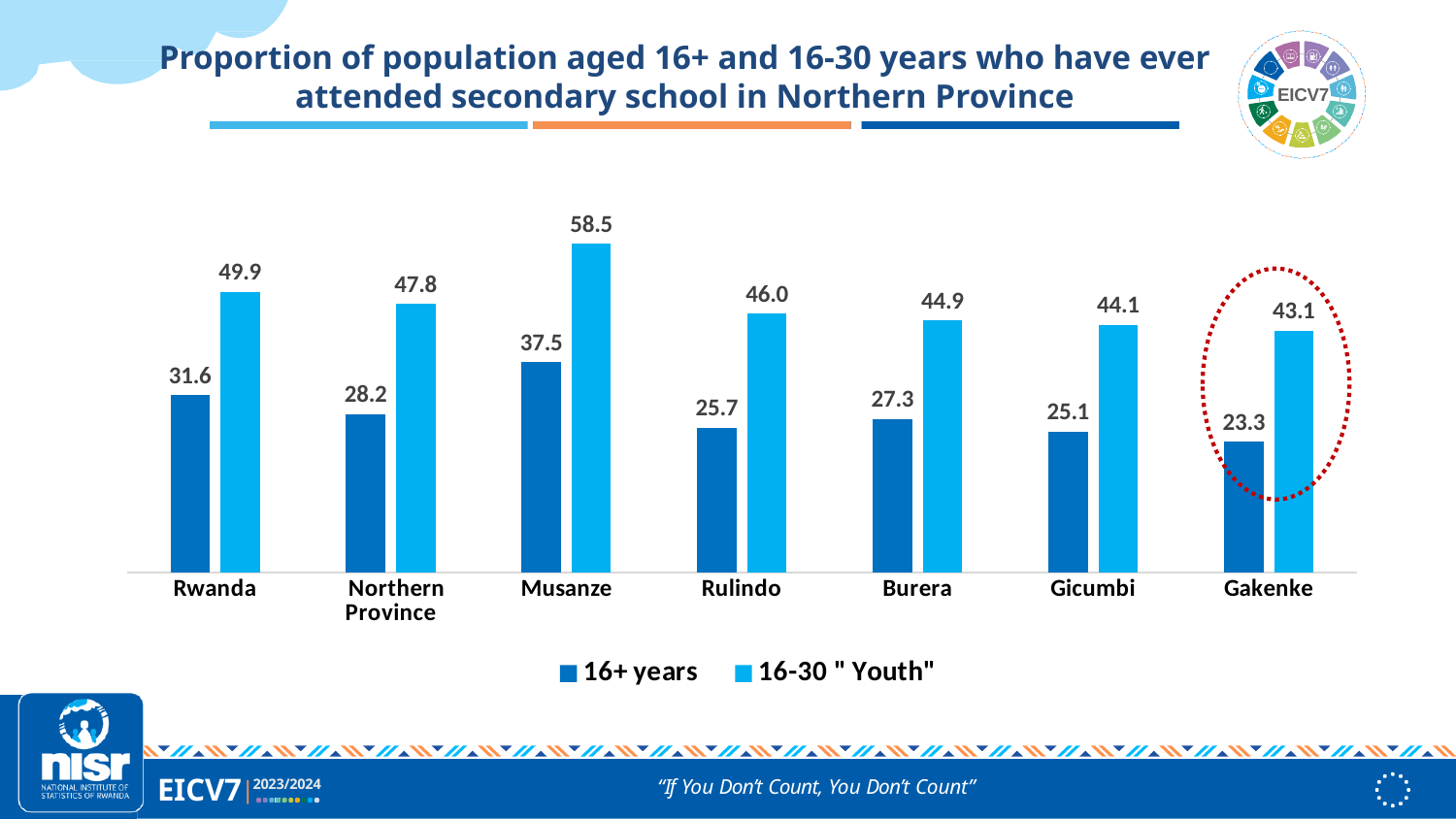
Which category on the chart is circled with a red dotted outline? Gakenke What is the value for Rwanda in the 16-30 "Youth" series? 49.9 How many categories are shown on the x axis? 7 Which is larger: the 16+ years value for Rulindo or the 16+ years value for Burera? Burera Which category has the highest value in the 16+ years series? Musanze What is the difference between the 16-30 "Youth" values for Musanze and Gicumbi? 14.4 What is the value for Musanze in the 16-30 "Youth" series? 58.5 What is the difference between the 16-30 "Youth" value and the 16+ years value for Northern Province? 19.6 Which category has the lowest value in the 16-30 "Youth" series? Gakenke What kind of chart is shown on the slide? Bar chart How many series does the legend list? 2 What is the value for Gakenke in the 16+ years series? 23.3